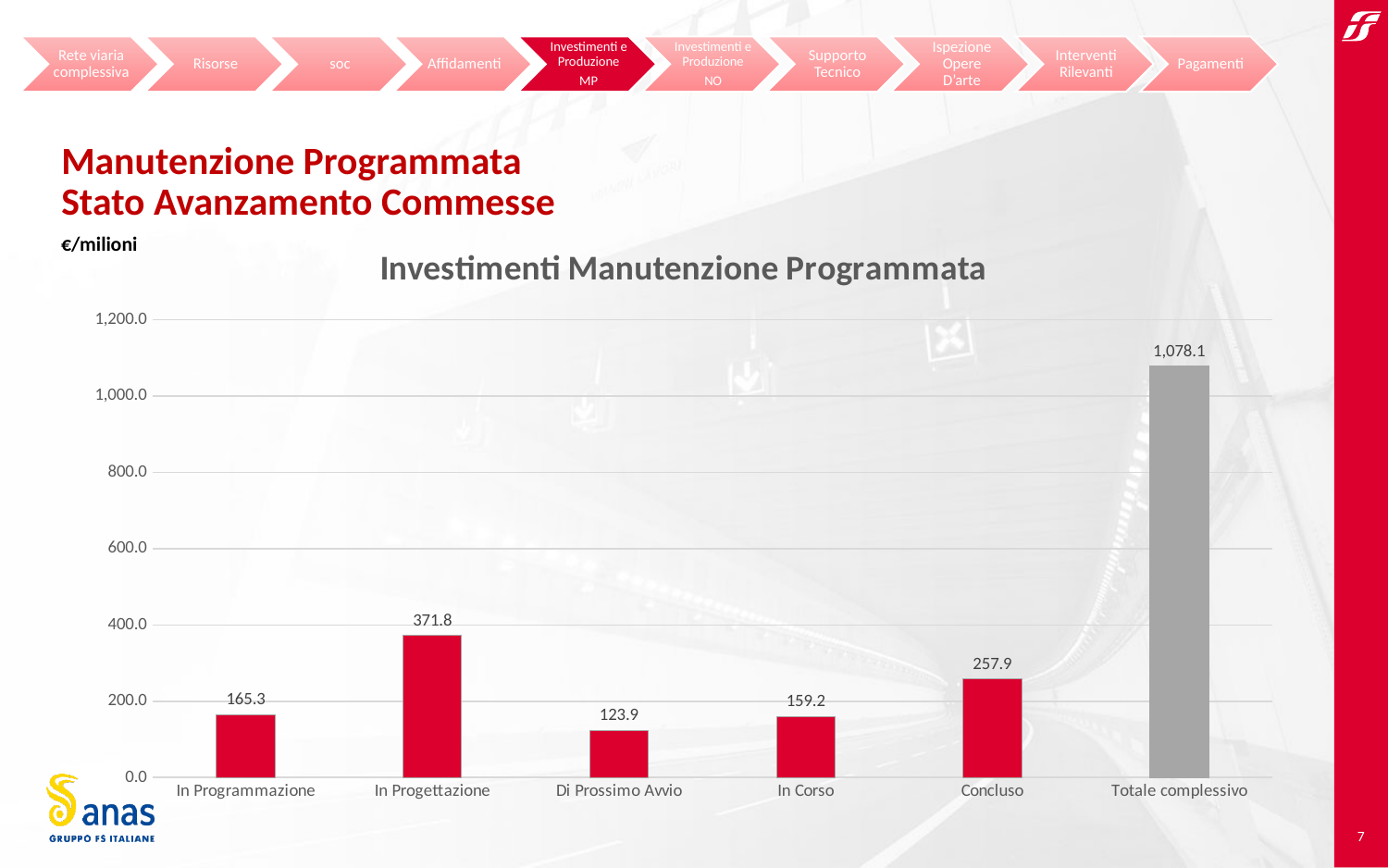
Is the value for Concluso greater or less than 200.0? greater What is the value for Totale complessivo? 1,078.1 What is the value for In Progettazione? 371.8 What is the value for Concluso? 257.9 Excluding the Totale complessivo bar, which category has the highest value? In Progettazione What is the value for Di Prossimo Avvio? 123.9 What is the difference between the values for In Progettazione and Concluso? 113.9 Which is larger, the value for In Programmazione or the value for In Corso? In Programmazione What kind of chart is shown on the slide? bar chart How many categories are shown on the x axis? 6 Which category has the lowest value? Di Prossimo Avvio What is the title of the chart? Investimenti Manutenzione Programmata